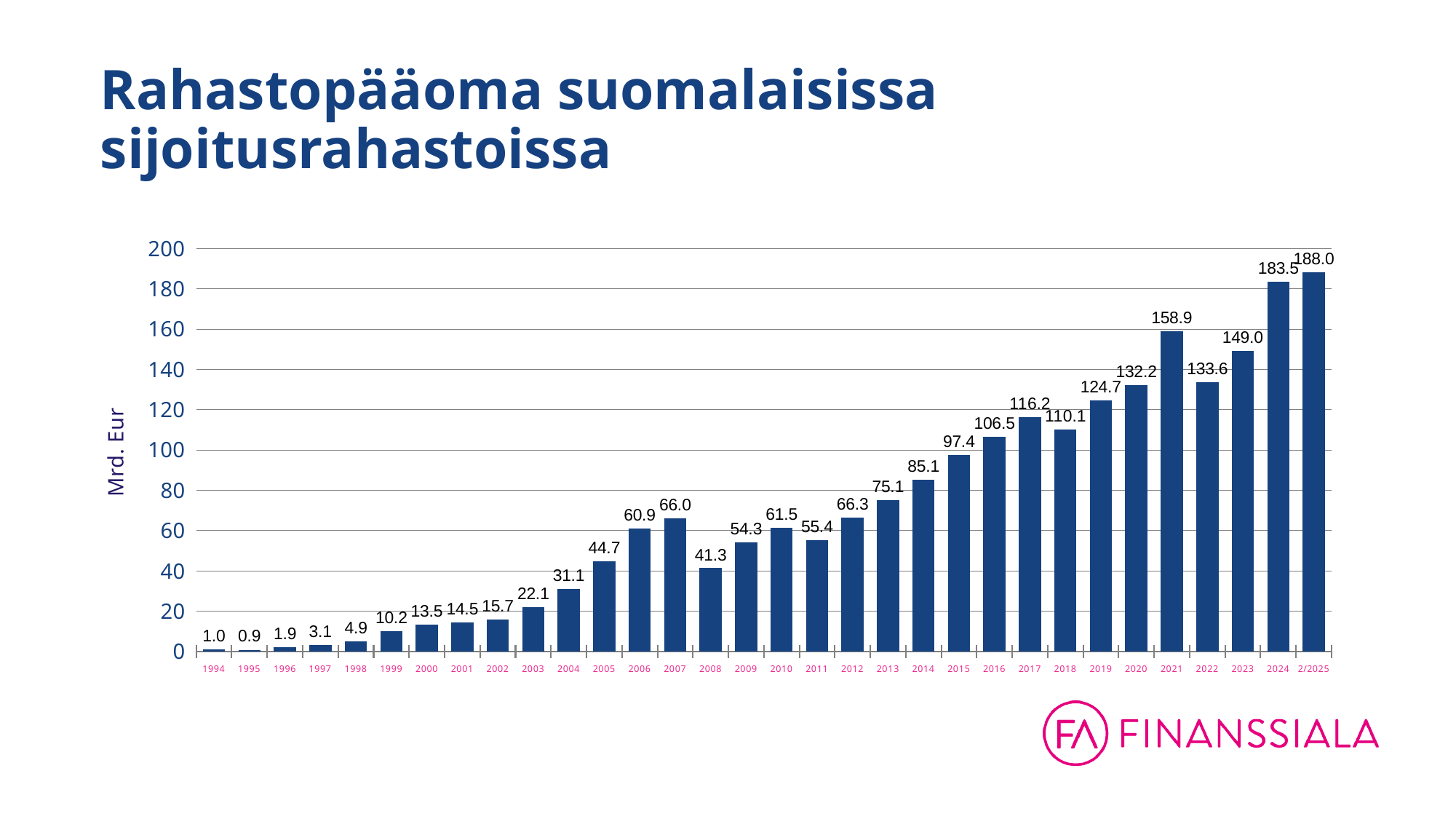
What is the difference between the values for 2021 and 2022? 25.3 What is the value for 2/2025? 188.0 What is the value for 2021? 158.9 What is the value for 2008? 41.3 Which category has the highest value? 2/2025 What is the difference between the values for 2024 and 2/2025? 4.5 Is the value for 2019 greater or less than 120? greater How many bars are shown in the chart? 32 What kind of chart is shown on the slide? Bar chart What is the label on the vertical axis? Mrd. Eur Which is larger, the value for 2007 or the value for 2012? 2012 Which year has the lowest value? 1995